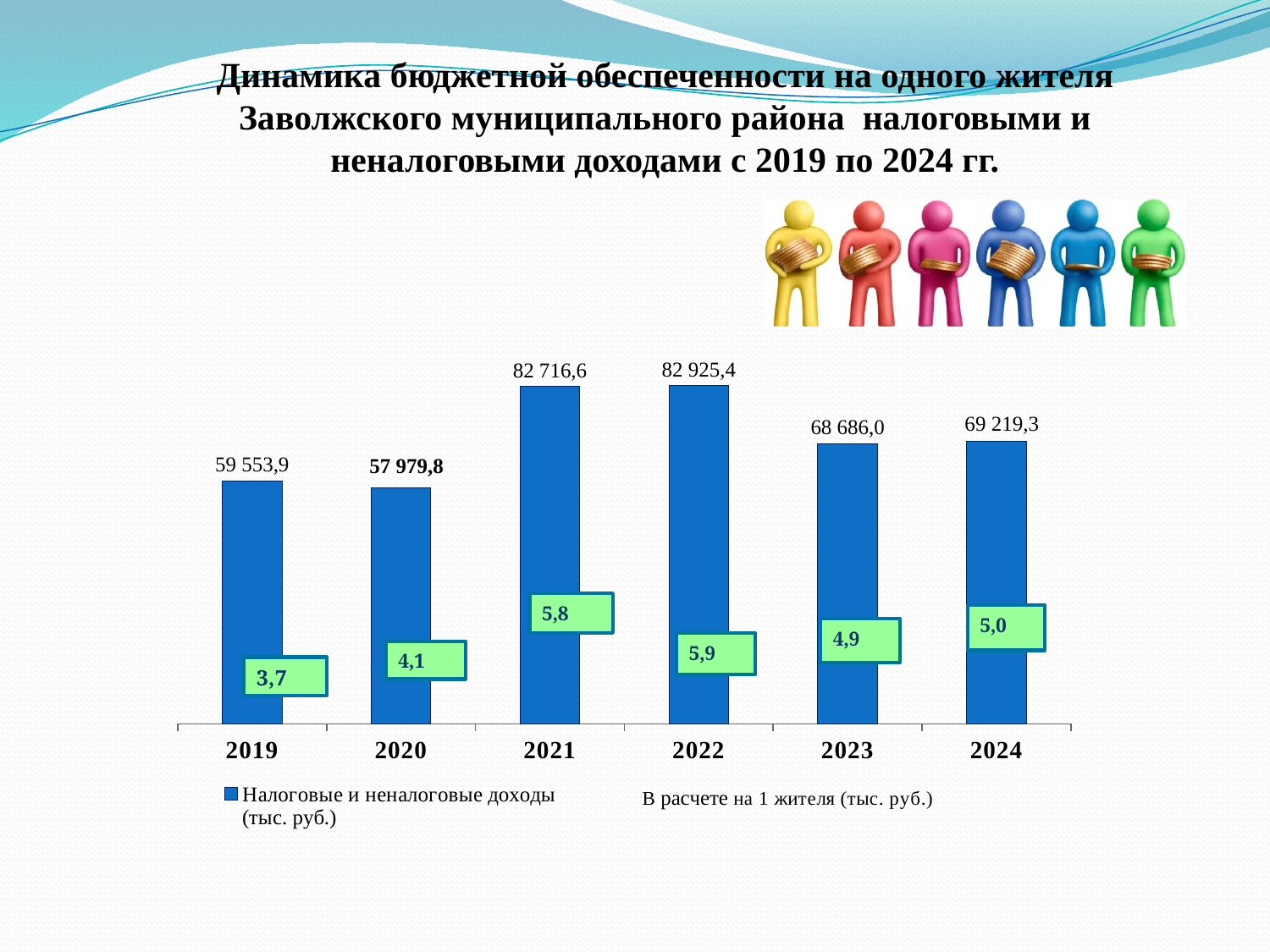
What is the per-resident value (В расчете на 1 жителя) shown for 2022? 5,9 Which year has the highest value of tax and non-tax revenues? 2022 What is the per-resident value (В расчете на 1 жителя) shown for 2024? 5,0 Which year has the lowest per-resident value (В расчете на 1 жителя)? 2019 What is the value of tax and non-tax revenues (Налоговые и неналоговые доходы) for 2021? 82 716,6 Which is larger, the tax and non-tax revenues for 2023 or for 2024? 2024 What is the difference between the tax and non-tax revenues for 2022 and 2021? 208,8 How many years are shown on the x axis of the chart? 6 What kind of chart is shown on the slide? Bar chart Which year has the lowest value of tax and non-tax revenues? 2020 What is the value of tax and non-tax revenues (Налоговые и неналоговые доходы) for 2019? 59 553,9 How many entries does the chart legend list? 1